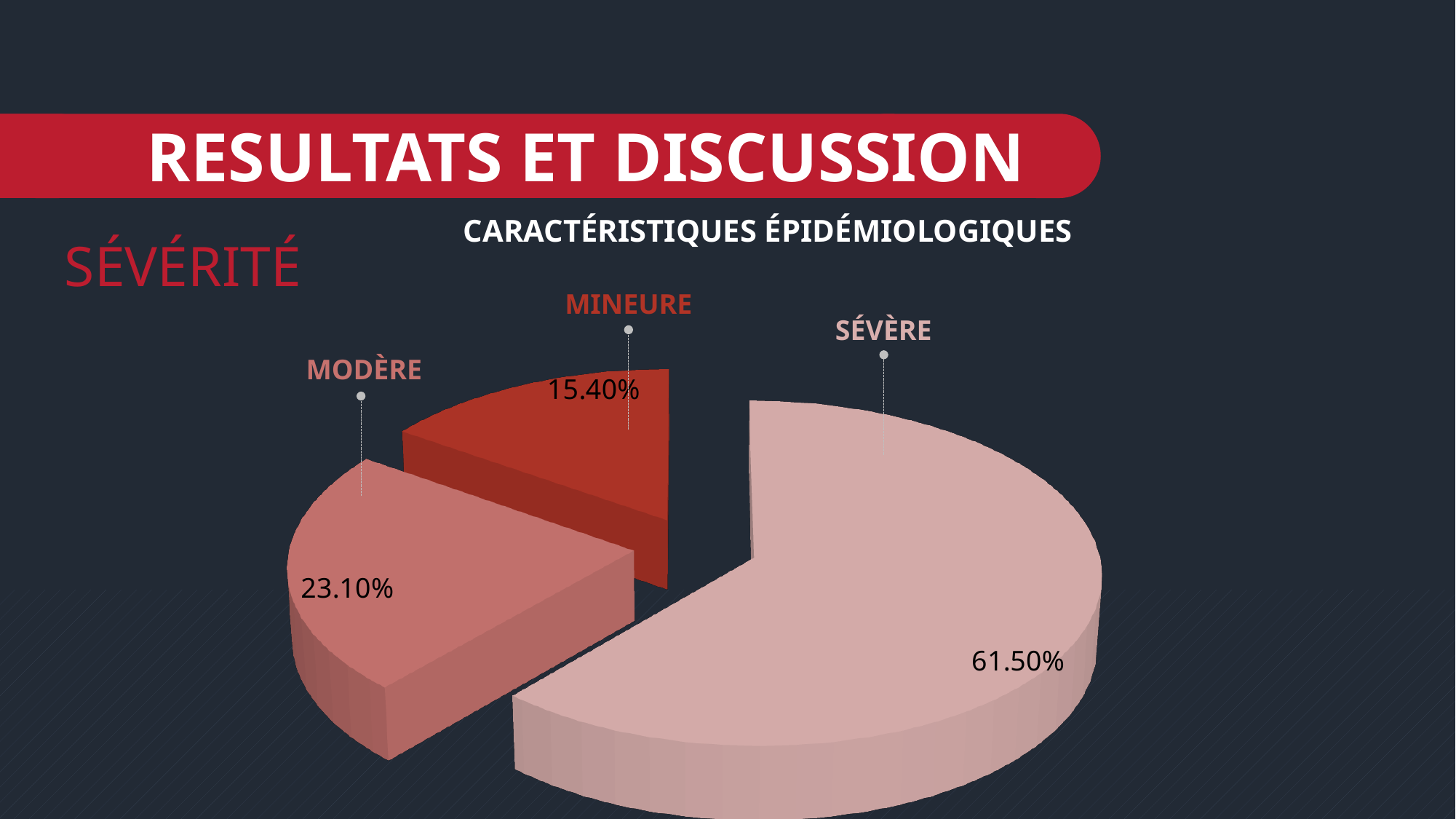
What percentage of cases are labelled MINEURE in the pie chart? 15.40% Which severity category has the largest slice of the pie chart? SÉVÈRE What percentage of cases are labelled MODÈRE in the pie chart? 23.10% What percentage of cases are labelled SÉVÈRE in the pie chart? 61.50% What is the combined share of the MODÈRE and MINEURE slices? 38.50% What is the title of the chart section shown in red on the left of the slide? SÉVÉRITÉ What is the difference in percentage points between the MODÈRE and MINEURE slices? 7.70% How many severity categories are shown in the pie chart? 3 What kind of chart is shown on the slide? Pie chart Which severity category has the smallest slice of the pie chart? MINEURE Which slice is larger, MODÈRE or MINEURE? MODÈRE What is the difference in percentage points between the SÉVÈRE and MODÈRE slices? 38.40%